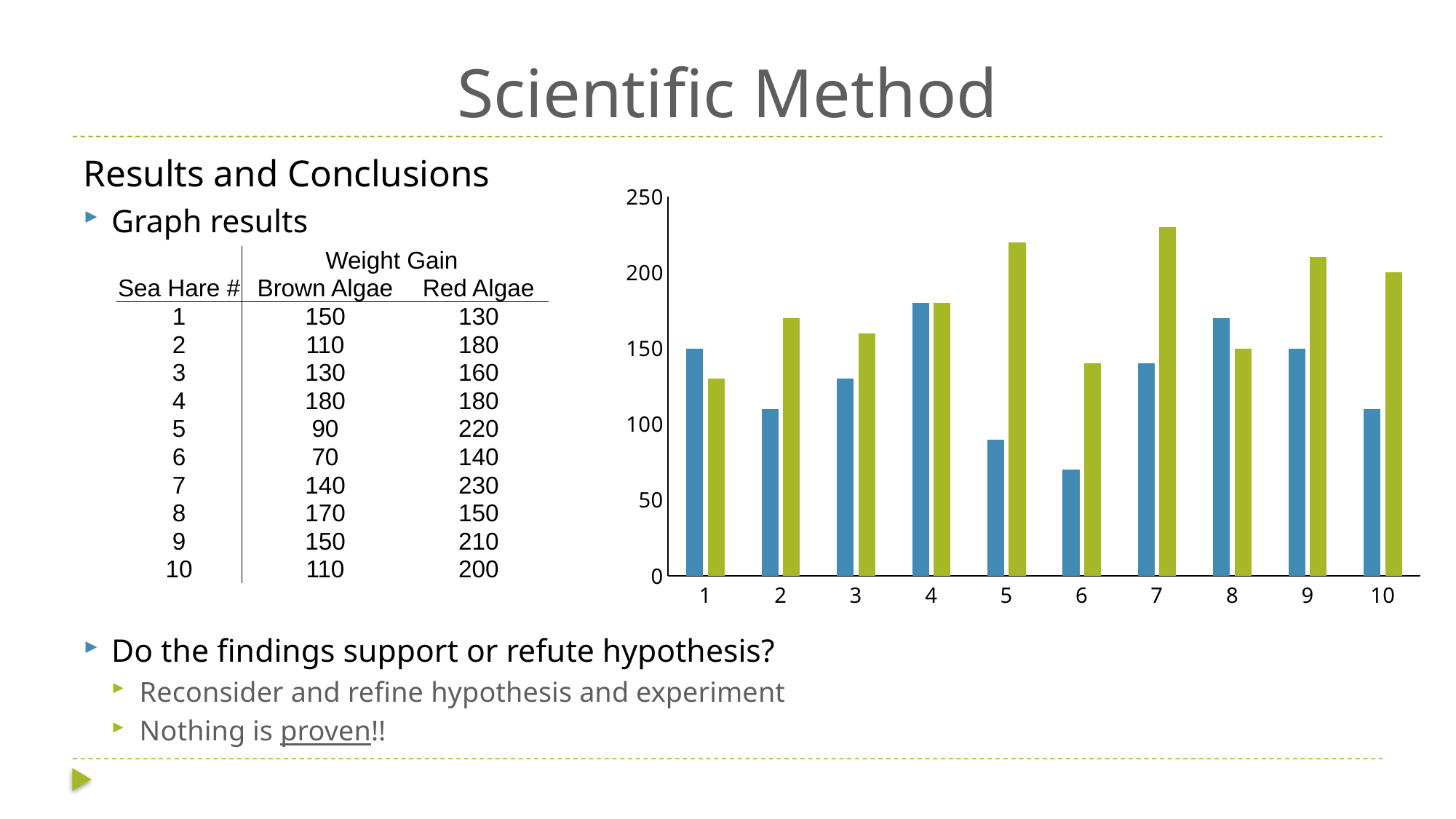
For sea hare 5, what is the difference between the Red Algae and Brown Algae weight gains shown in the table? 130 Is the value of the blue bar for sea hare 6 greater or less than 100? less Is the value of the green bar for sea hare 9 greater or less than 200? greater According to the table, what is the Brown Algae weight gain for sea hare 1? 150 Which sea hare number has the shortest blue bar in the chart? 6 How many bars are plotted for each sea hare number in the chart? 2 How many sea hare numbers are shown along the x axis of the chart? 10 For sea hare 8, which bar is taller, the blue bar or the green bar? the blue bar According to the table, what is the Red Algae weight gain for sea hare 7? 230 What is the highest value labelled on the chart's vertical axis? 250 Which sea hare number has the tallest green bar in the chart? 7 What kind of chart is shown on the slide? bar chart